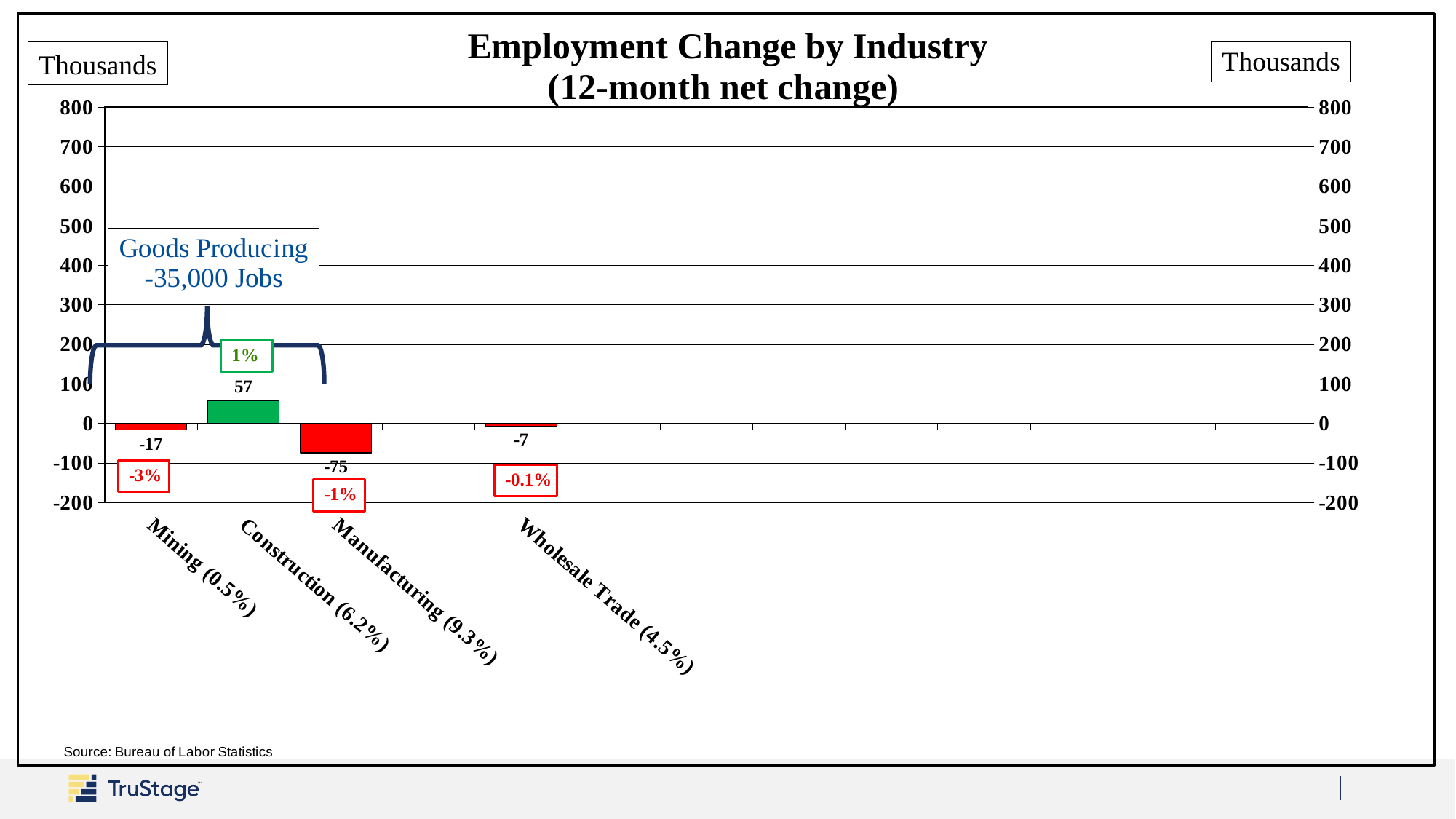
Which has a larger net employment change, Mining or Wholesale Trade? Wholesale Trade Is the value for Construction greater or less than 100? less What is the 12-month net employment change for Construction? 57 What is the difference between the net employment change for Construction and for Manufacturing? 132 What is the title of the chart? Employment Change by Industry (12-month net change) How many industries are shown on the chart? 4 What kind of chart is shown on the slide? Bar chart What is the 12-month net employment change for Wholesale Trade? -7 What is the 12-month net employment change for Manufacturing? -75 Which industry has the highest 12-month net employment change? Construction What is the 12-month net employment change for Mining? -17 Which industry has the lowest 12-month net employment change? Manufacturing